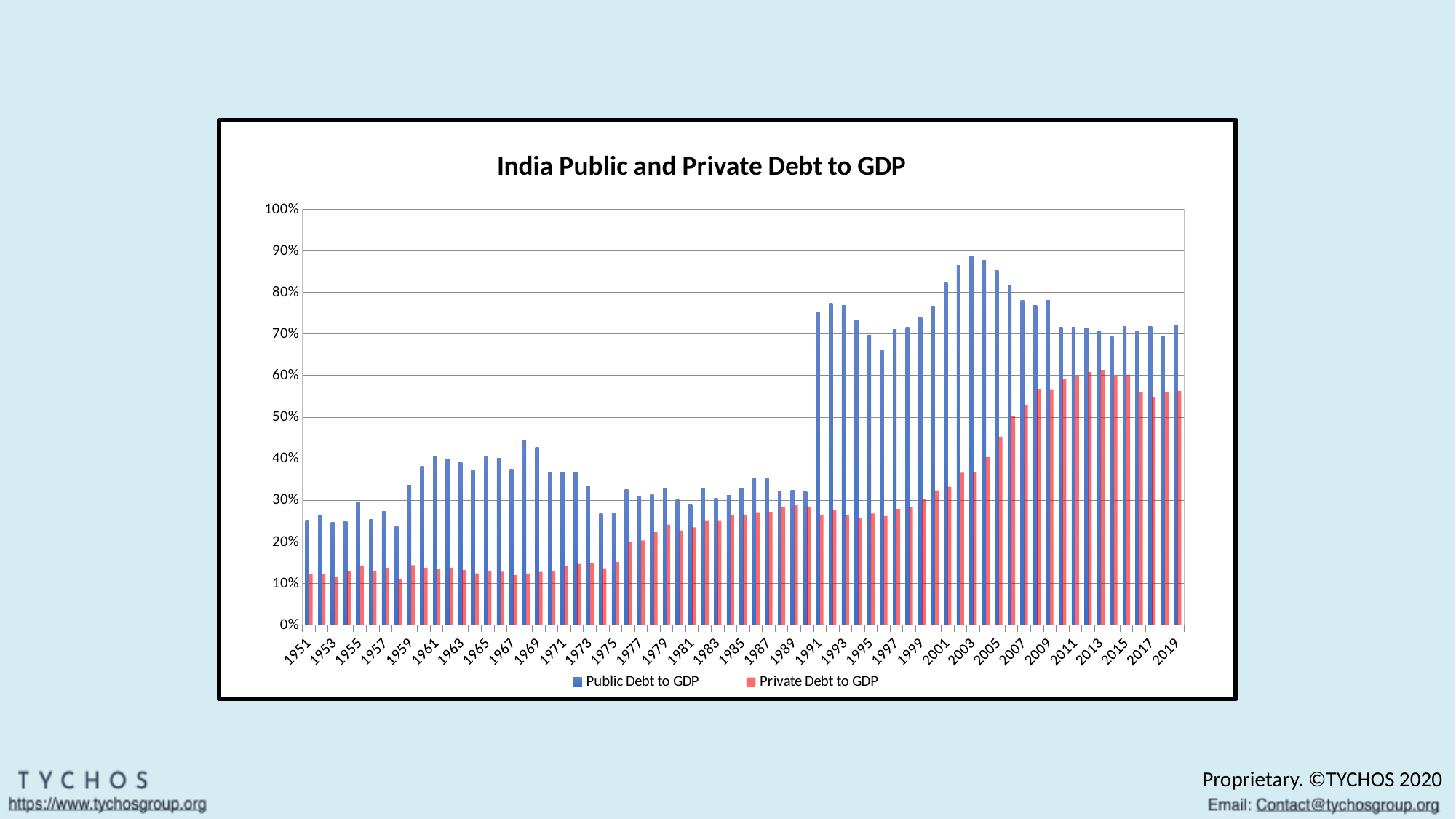
Is the value for Private Debt to GDP in 2013 greater or less than 50%? greater Is the value for Private Debt to GDP in 1951 greater or less than 20%? less How many series does the legend list? 2 In which year is Public Debt to GDP at its highest? 2003 Which series is shown in red bars? Private Debt to GDP Is the value for Public Debt to GDP in 1991 greater or less than 70%? greater What is the title of the chart? India Public and Private Debt to GDP Does Private Debt to GDP generally rise or fall from 1991 to 2019? Rise What kind of chart is shown on the slide? Bar chart In 2019, which is larger: Public Debt to GDP or Private Debt to GDP? Public Debt to GDP